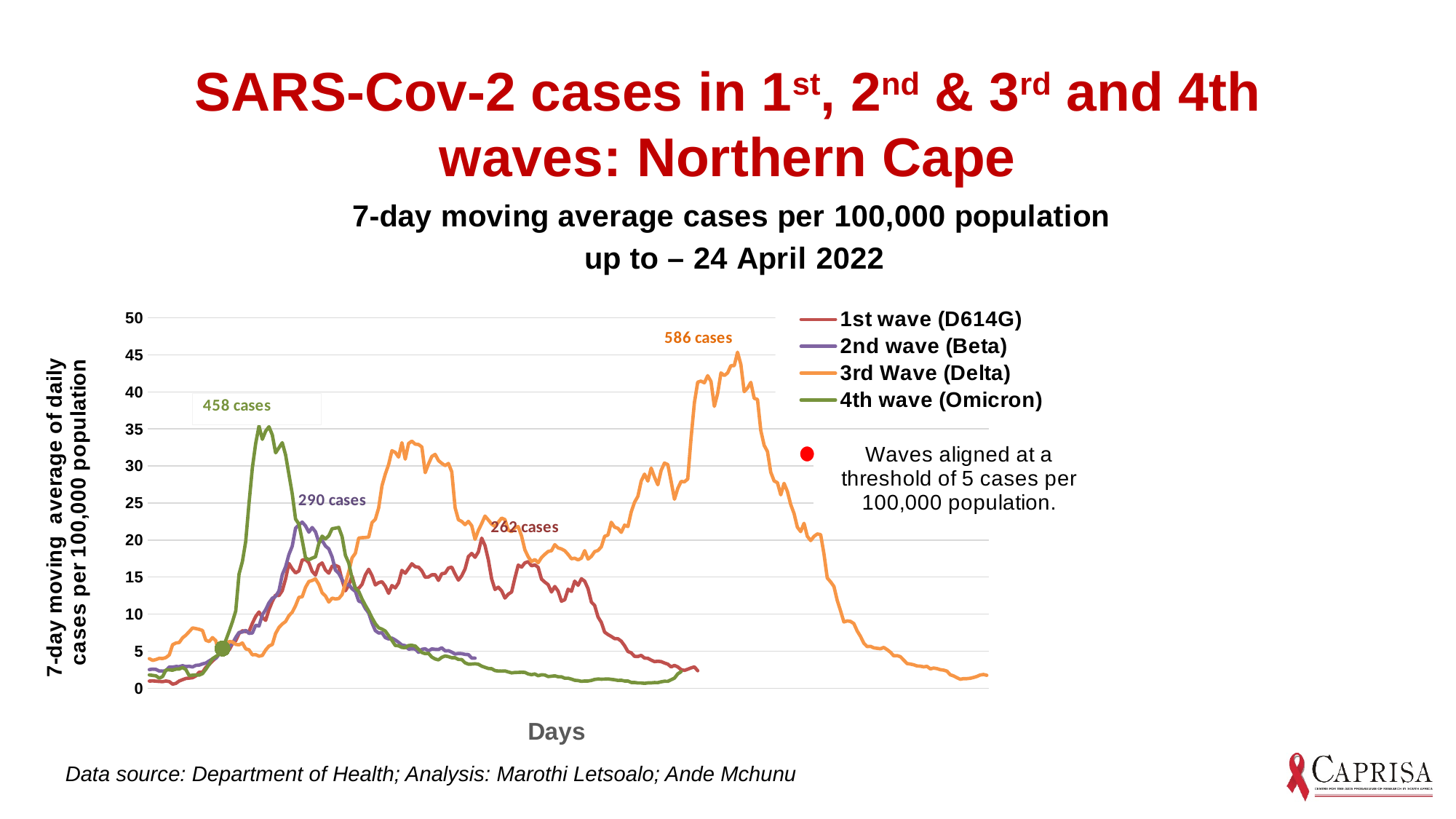
Is the peak of the 1st wave (D614G) line greater or less than 25 cases per 100,000? less What peak case count is labelled for the 4th wave (Omicron)? 458 cases At what threshold of cases per 100,000 population are the waves aligned? 5 cases per 100,000 population Which wave reaches the highest peak on the chart? 3rd Wave (Delta) What peak case count is labelled for the 3rd wave (Delta)? 586 cases What kind of chart is shown on the slide? line chart What is the difference between the labelled peak case counts of the 3rd wave and the 4th wave? 128 cases Is the peak of the 3rd Wave (Delta) line greater or less than 40 cases per 100,000? greater How many series does the legend list? 4 Which wave has the lowest labelled peak case count? 1st wave (D614G) What peak case count is labelled for the 1st wave (D614G)? 262 cases What peak case count is labelled for the 2nd wave (Beta)? 290 cases